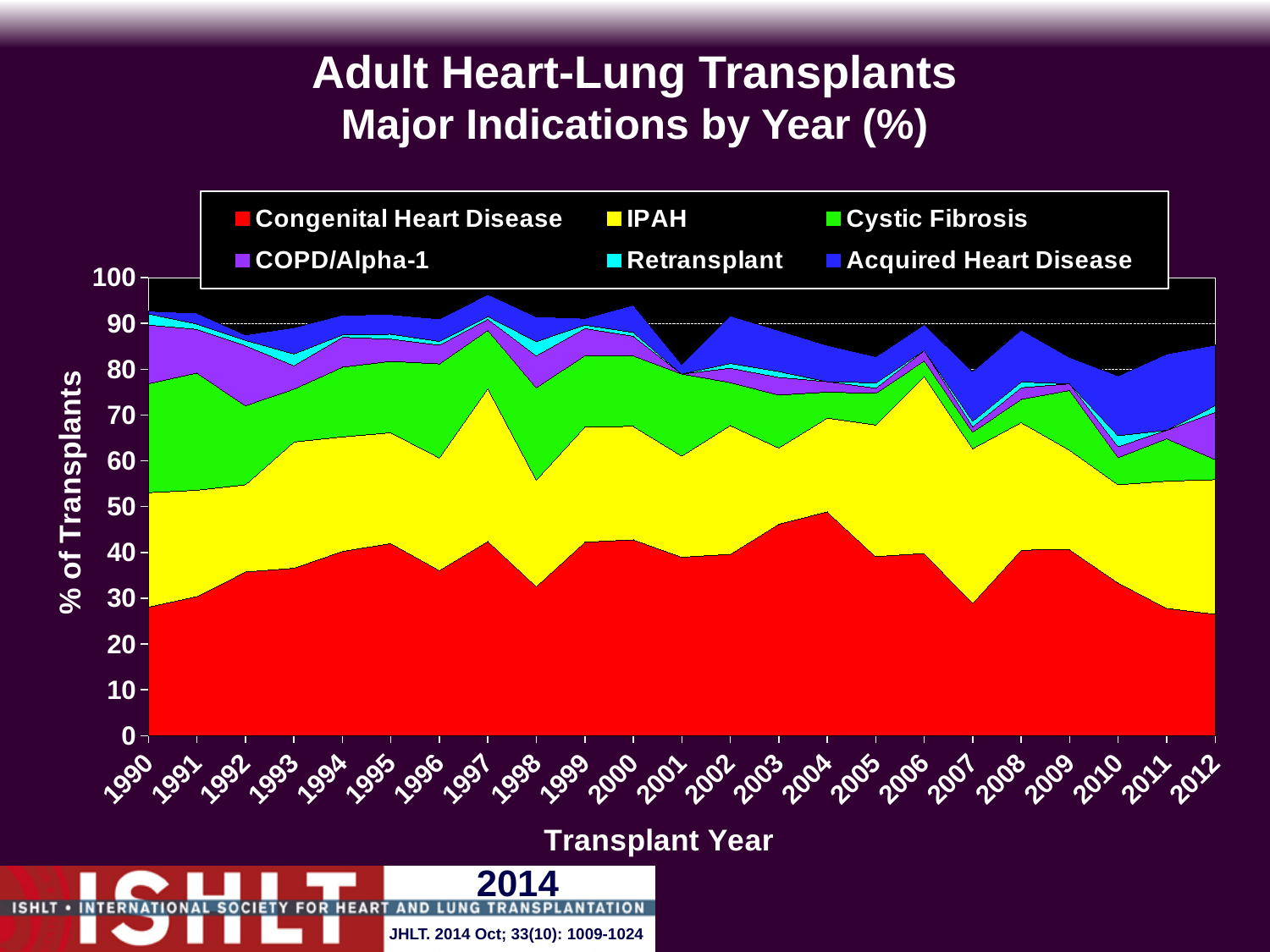
Is the value for Congenital Heart Disease in 2004 greater or less than 40? greater Is the value for Congenital Heart Disease in 1998 greater or less than 40? less Is the value for Congenital Heart Disease in 1996 greater or less than 40? less Which year is the first on the x axis? 1990 In which year does Congenital Heart Disease reach its highest share? 2004 Does the Congenital Heart Disease share rise or fall from 1990 to 1995? Rise Which year is the last on the x axis? 2012 Which is larger, the Congenital Heart Disease share in 2004 or in 1990? 2004 What kind of chart is shown on the slide? Stacked area chart How many transplant years are plotted along the x axis? 23 How many series does the legend list? 6 Does the Congenital Heart Disease share rise or fall from 2004 to 2007? Fall